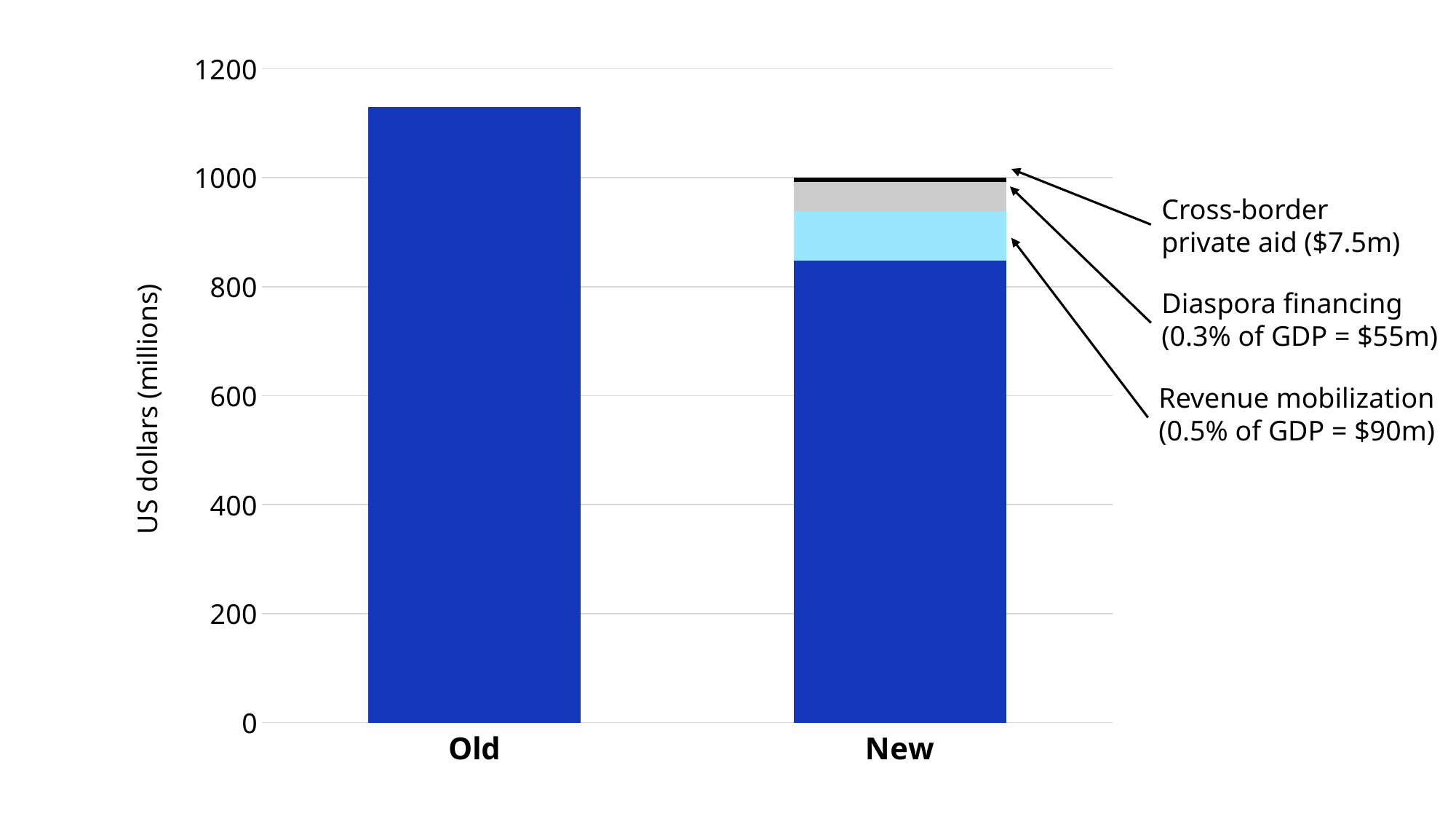
Which category has the taller bar, Old or New? Old What value is given for Diaspora financing in the New bar? $55m How many categories are shown on the x axis? 2 Is the value for Old greater or less than 1000? greater What kind of chart is shown on the slide? bar chart Is the total height of the New bar greater or less than 800? greater What is the difference between the Revenue mobilization and Diaspora financing amounts? $35m Is the value for Old greater or less than 1200? less What percentage of GDP does Diaspora financing represent? 0.3% What value is given for Revenue mobilization in the New bar? $90m What is the label on the y axis? US dollars (millions) What value is given for Cross-border private aid in the New bar? $7.5m